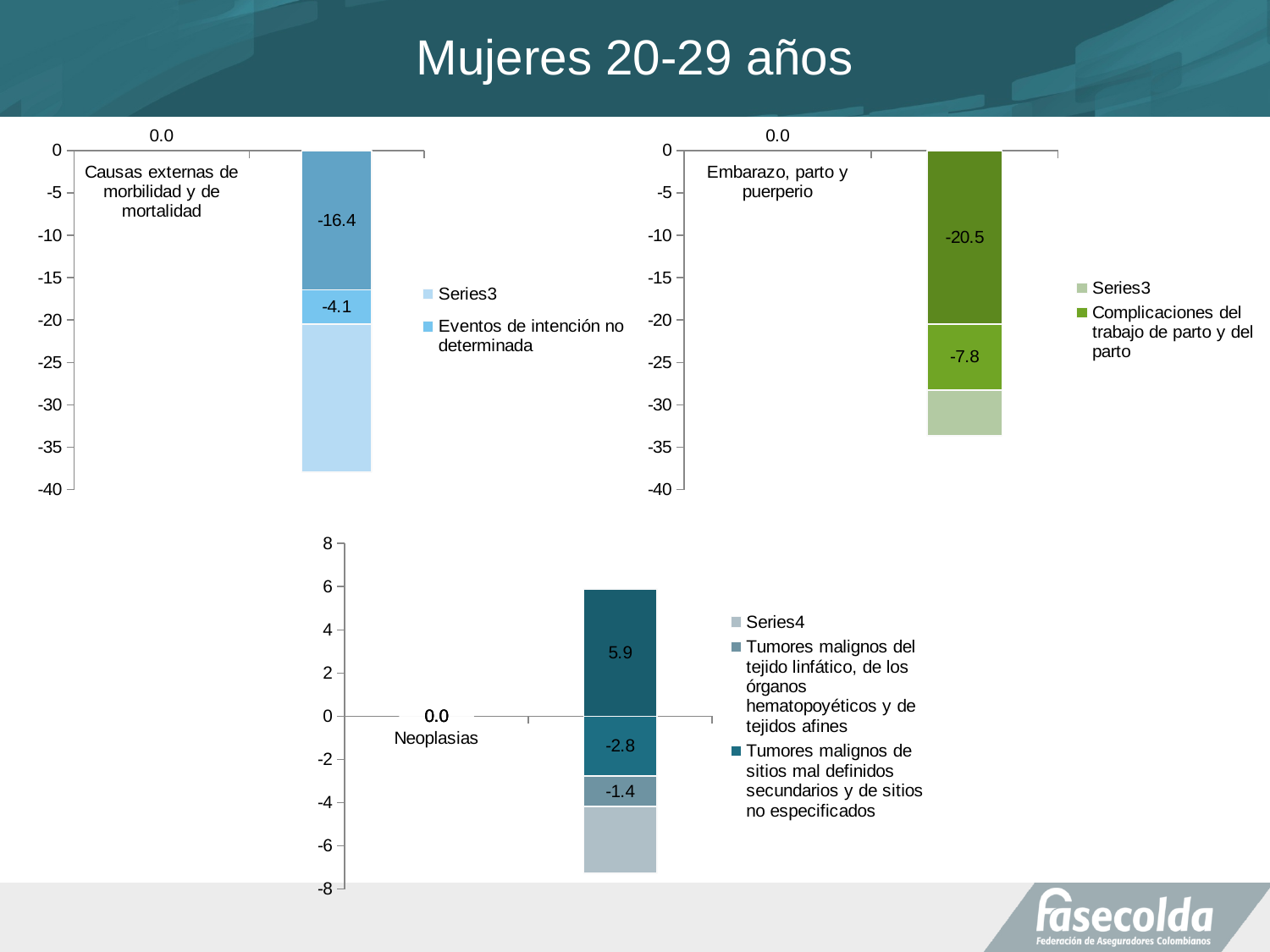
In the 'Neoplasias' chart, what value is printed on the segment above the zero line? 5.9 How many entries does the legend of the 'Neoplasias' chart list? 3 In the 'Neoplasias' chart, what value is printed on the lowest labeled segment of the stacked bar? -1.4 How many entries does the legend of the 'Embarazo, parto y puerperio' chart list? 2 In the 'Embarazo, parto y puerperio' chart, what value is printed on the second labeled segment of the stacked bar? -7.8 In the 'Causas externas de morbilidad y de mortalidad' chart, what value is printed on the topmost segment of the stacked bar? -16.4 What kind of chart is the 'Neoplasias' chart? Stacked bar chart In the 'Neoplasias' chart, what is the difference between the 5.9 segment and the -2.8 segment? 8.7 In the 'Causas externas de morbilidad y de mortalidad' chart, what value is printed on the second labeled segment of the stacked bar? -4.1 In the 'Embarazo, parto y puerperio' chart, what value is printed on the topmost segment of the stacked bar? -20.5 In the 'Causas externas de morbilidad y de mortalidad' chart, what is the difference between the -4.1 segment and the -16.4 segment? 12.3 In the 'Embarazo, parto y puerperio' chart, does the stacked bar extend below -30 on the axis? Yes